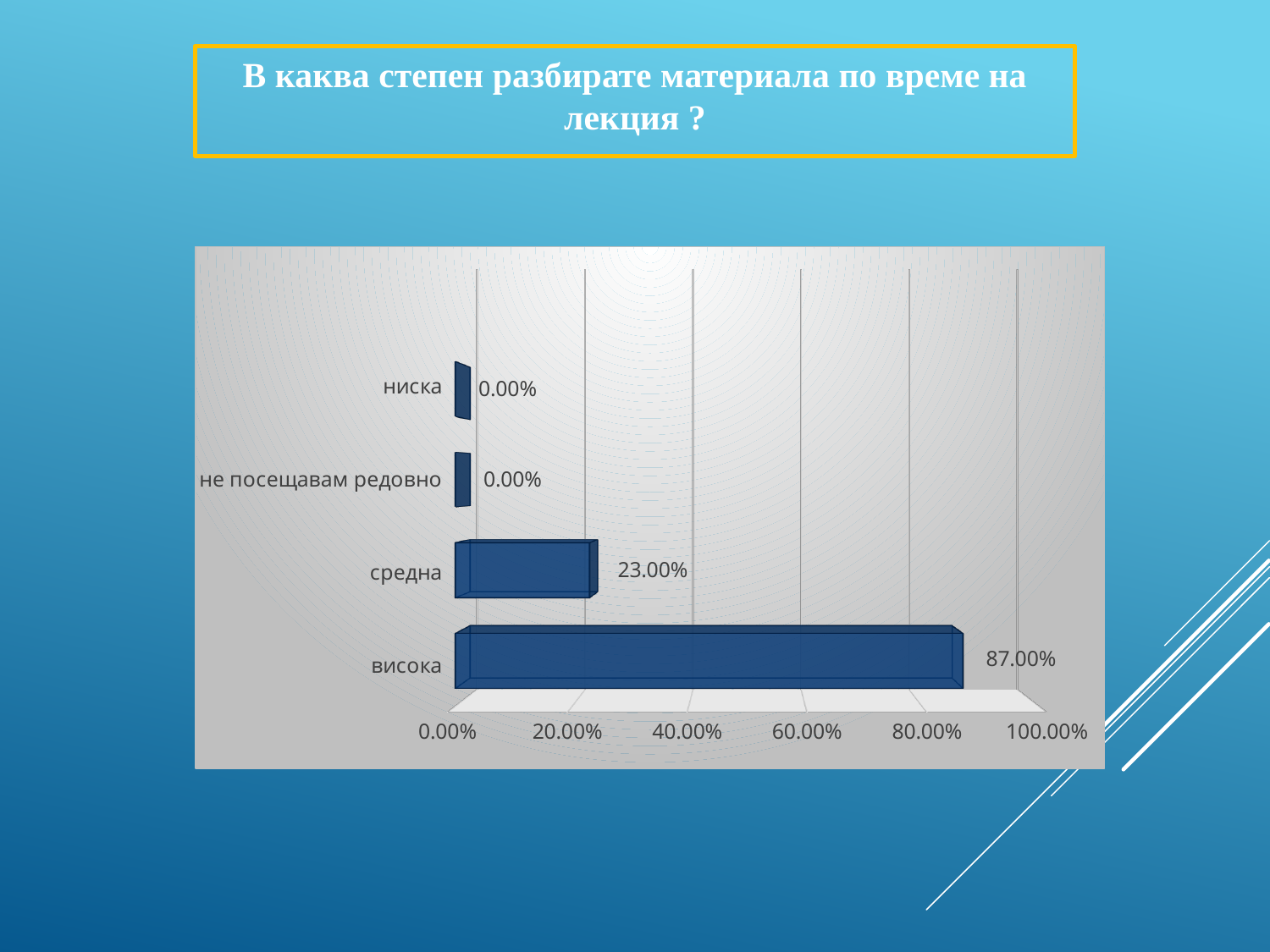
What is the title of the slide above the chart? В каква степен разбирате материала по време на лекция ? What kind of chart is shown on the slide? bar chart What is the value for "не посещавам редовно"? 0.00% What is the difference between the values for "висока" and "средна"? 64.00% What is the value for "ниска"? 0.00% What is the value for "висока"? 87.00% Which is larger, the value for "средна" or the value for "висока"? висока How many categories are shown in the chart? 4 Is the value for "висока" greater or less than 80.00%? greater Which category has the highest value? висока What is the value for "средна"? 23.00% Is the value for "средна" greater or less than 40.00%? less